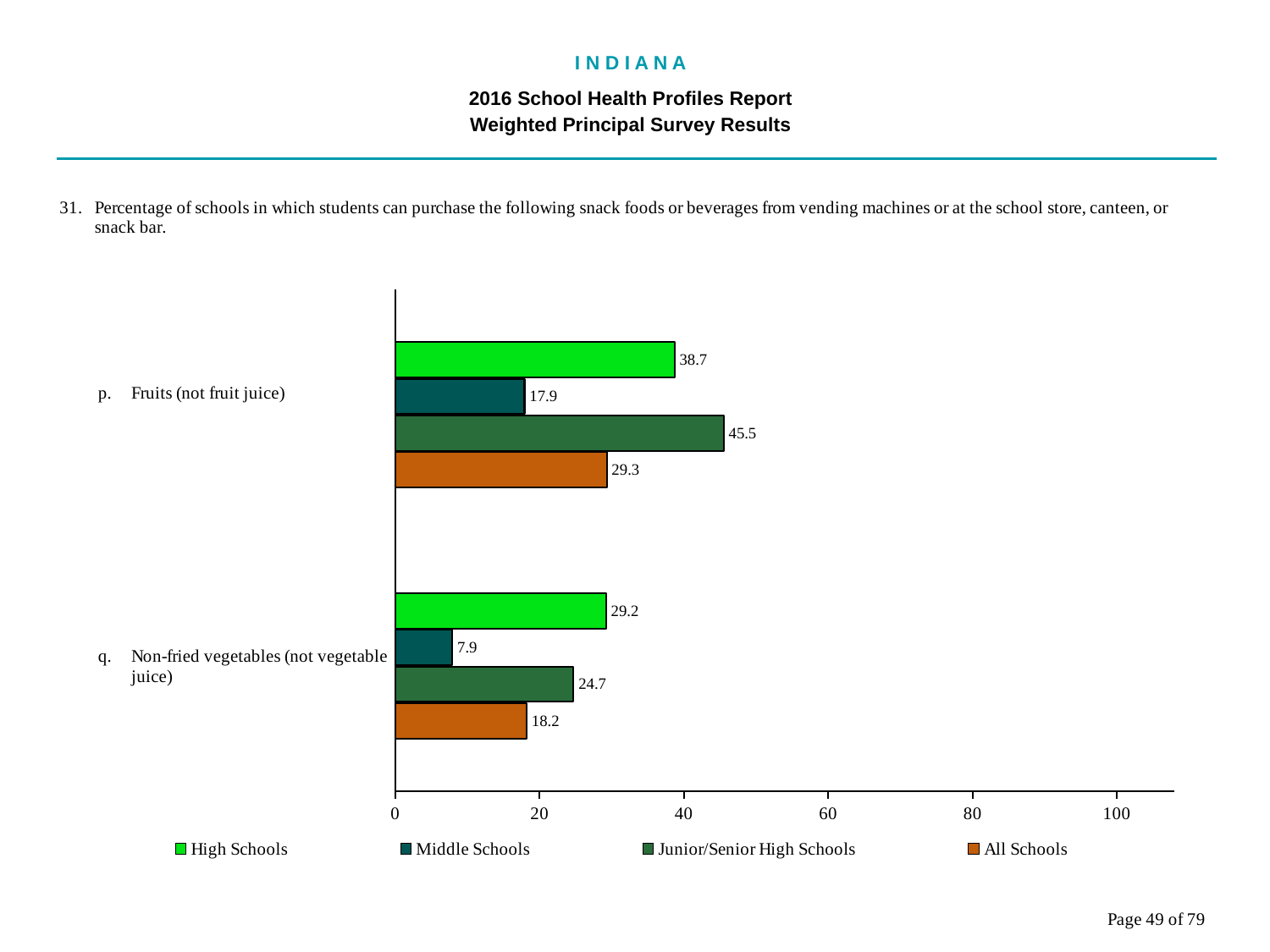
What is the value for All Schools for Fruits (not fruit juice)? 29.3 How many series does the legend list? 4 Which school type has the highest value for Fruits (not fruit juice)? Junior/Senior High Schools Which school type has the lowest value for Non-fried vegetables (not vegetable juice)? Middle Schools Which is larger: the Middle Schools value for Fruits (not fruit juice) or the All Schools value for Non-fried vegetables (not vegetable juice)? All Schools value for Non-fried vegetables (not vegetable juice) What is the value for Junior/Senior High Schools for Fruits (not fruit juice)? 45.5 How many snack food categories are shown in the chart? 2 What colour represents All Schools in the legend? orange What is the difference between the High Schools values for Fruits (not fruit juice) and Non-fried vegetables (not vegetable juice)? 9.5 What is the value for Middle Schools for Non-fried vegetables (not vegetable juice)? 7.9 Is the value for Junior/Senior High Schools for Fruits (not fruit juice) greater or less than 40? greater What kind of chart is shown on the slide? bar chart